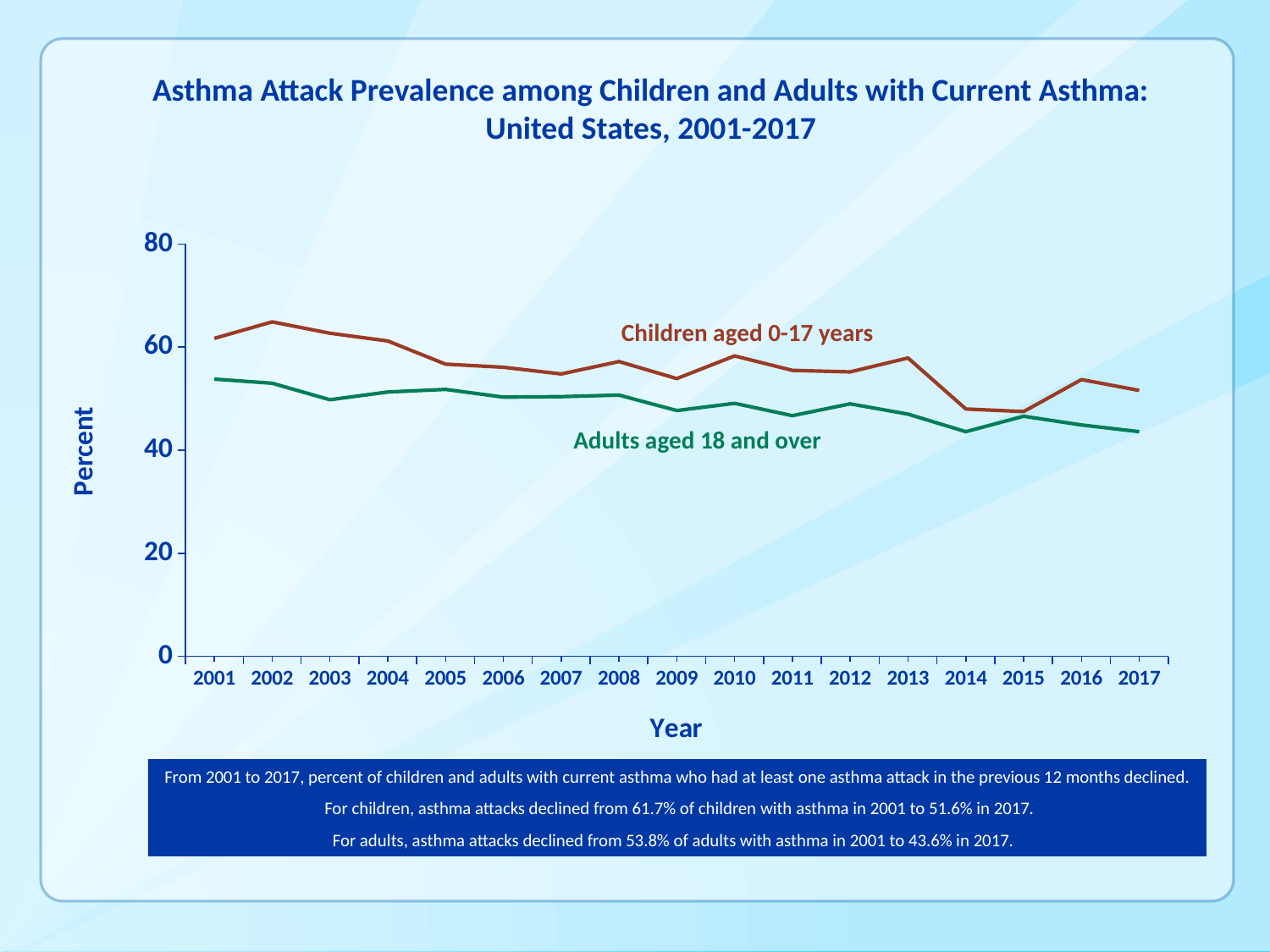
Which series had the higher value in 2002, children aged 0-17 years or adults aged 18 and over? Children aged 0-17 years What kind of chart is shown on the slide? Line chart What was the asthma attack prevalence for children aged 0-17 years in 2017? 51.6% Overall, do the values for children aged 0-17 years rise or fall from 2001 to 2017? Fall Is the value for adults aged 18 and over in 2014 greater or less than 60? less What was the asthma attack prevalence for adults aged 18 and over in 2001? 53.8% How many years are shown along the x axis of the chart? 17 By how many percentage points did asthma attack prevalence among adults aged 18 and over decline from 2001 to 2017? 10.2 By how many percentage points did asthma attack prevalence among children aged 0-17 years decline from 2001 to 2017? 10.1 What was the asthma attack prevalence for children aged 0-17 years in 2001? 61.7% What was the asthma attack prevalence for adults aged 18 and over in 2017? 43.6% How many series are plotted on the chart? 2